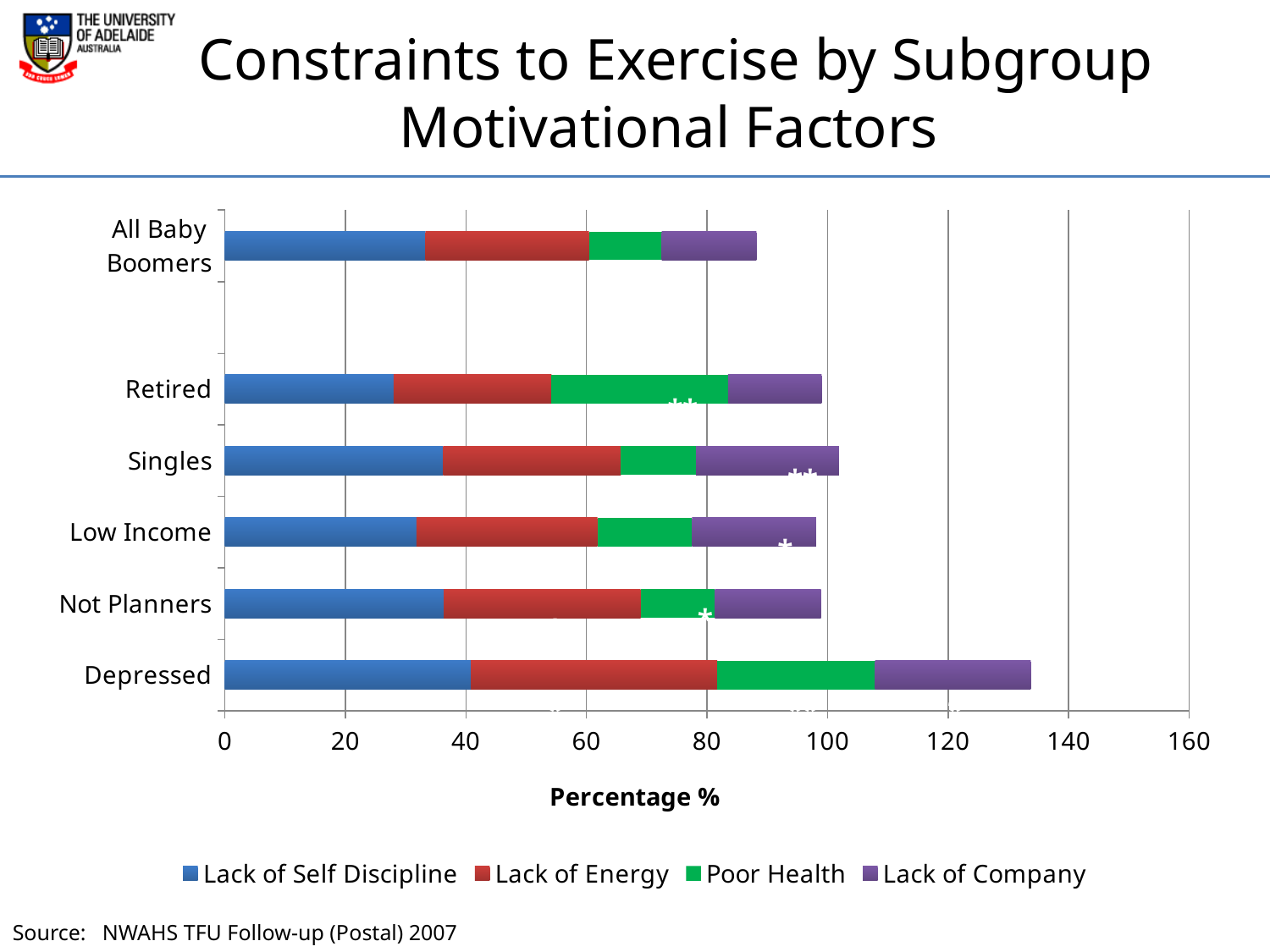
How many subgroup categories are plotted on the chart? 6 Which has the larger total stacked bar, Depressed or All Baby Boomers? Depressed Which subgroup has the larger Lack of Self Discipline segment, Depressed or Retired? Depressed Is the total stacked bar for All Baby Boomers greater or less than 100? less Which subgroup has the longest total stacked bar? Depressed Is the Lack of Self Discipline value for Retired greater or less than 20? greater How many series does the legend list? 4 Which subgroup has the shortest total stacked bar? All Baby Boomers Which series is shown in green in the legend? Poor Health Is the total stacked bar for Depressed greater or less than 120? greater What kind of chart is shown on the slide? Stacked bar chart What is the title of the horizontal axis? Percentage %